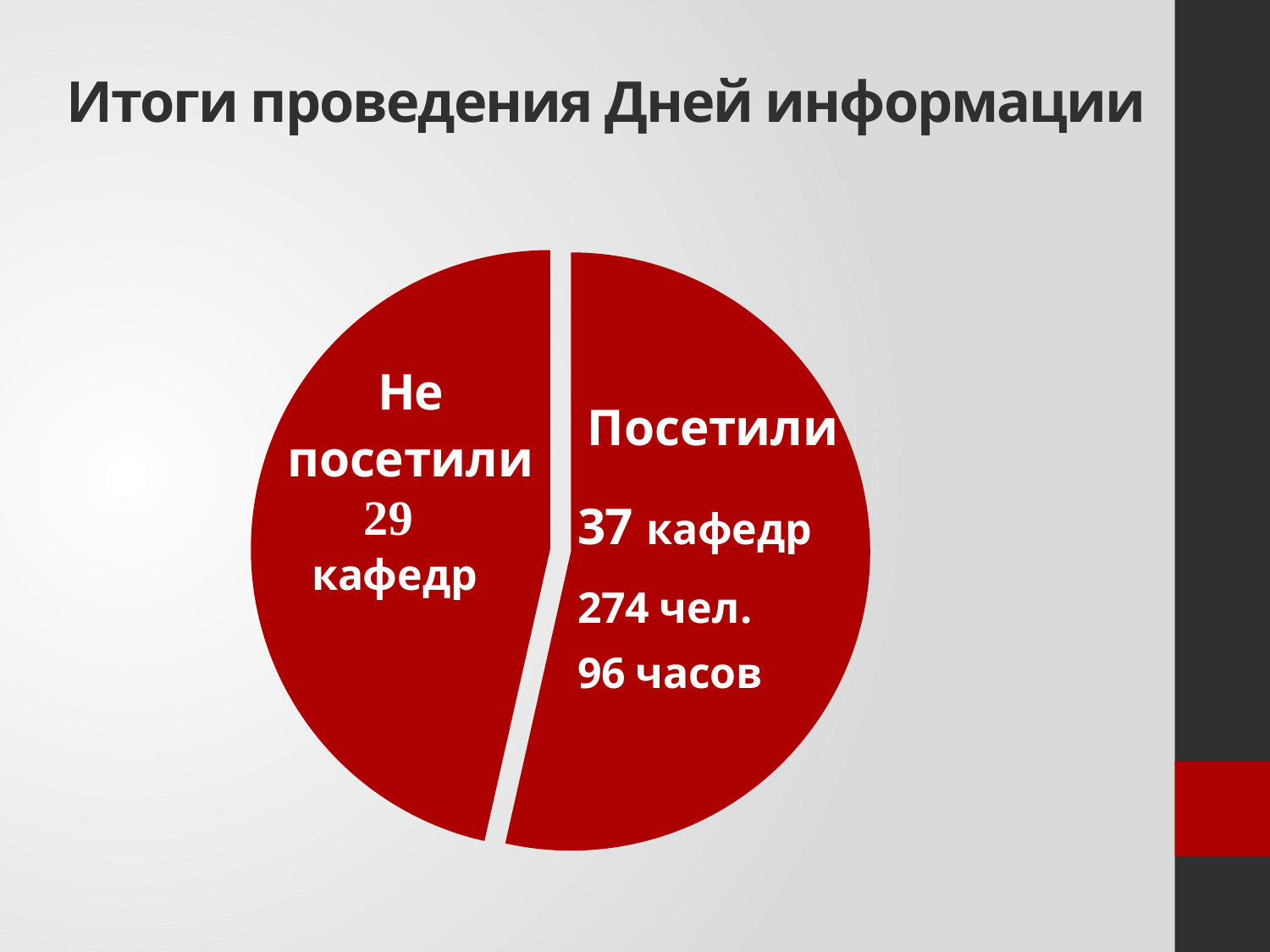
What kind of chart is shown on the slide? pie chart What is the title of the slide containing the pie chart? Итоги проведения Дней информации Which slice of the pie chart is the largest? Посетили How many hours (часов) are listed for the "Посетили" slice? 96 часов Which slice of the pie chart is the smallest? Не посетили Which has more кафедр, "Посетили" or "Не посетили"? Посетили How many кафедр are in the "Не посетили" slice? 29 кафедр What is the difference in the number of кафедр between "Посетили" and "Не посетили"? 8 How many кафедр are in the "Посетили" slice? 37 кафедр How many slices does the pie chart have? 2 What colour are the slices of the pie chart? red How many people (чел.) are listed for the "Посетили" slice? 274 чел.